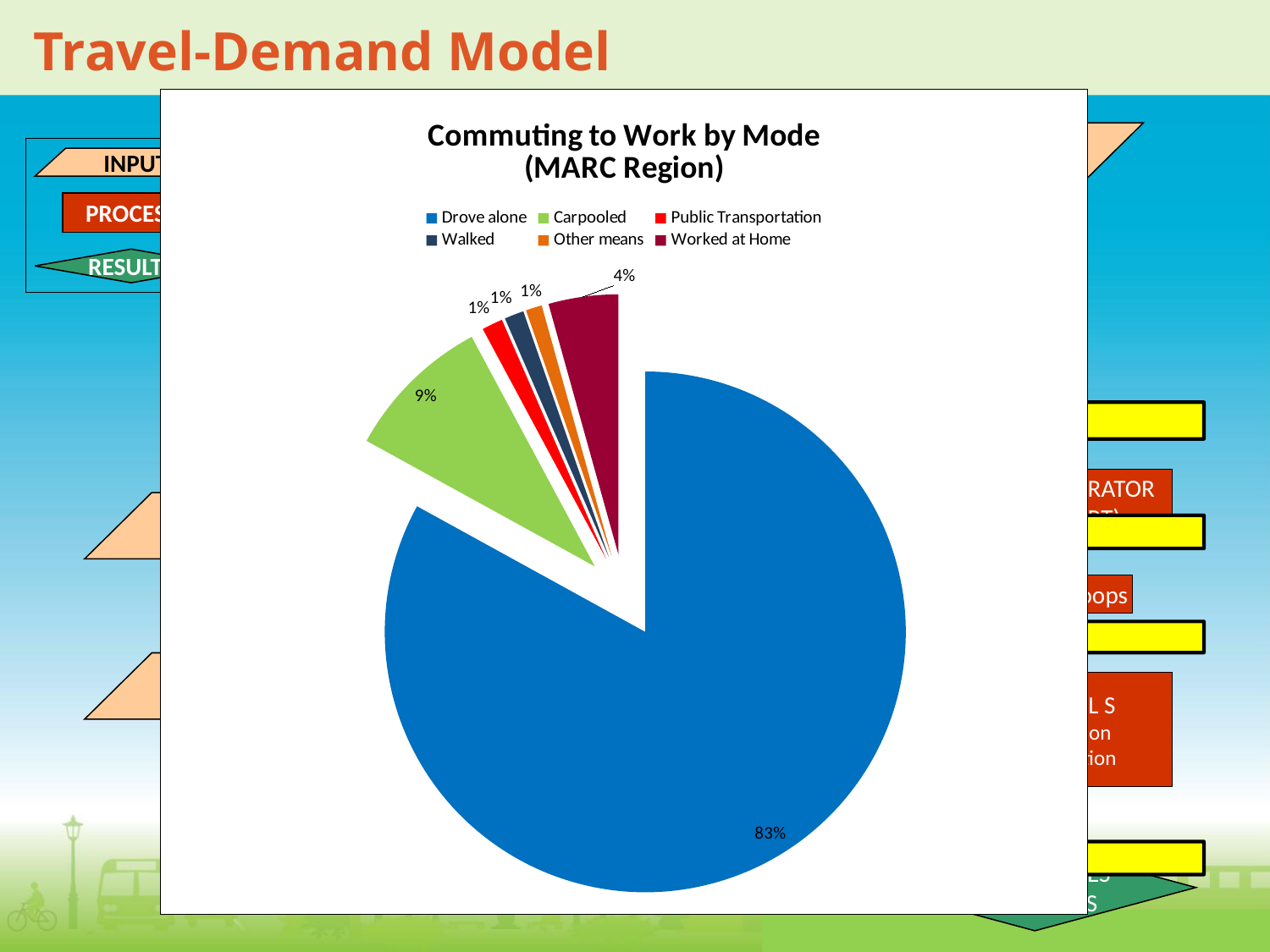
Which commuting mode has the largest share of the pie? Drove alone What is the title of the chart? Commuting to Work by Mode (MARC Region) What percentage of commuters used public transportation? 1% What colour is the Drove alone slice? Blue What percentage of commuters worked at home? 4% How many entries does the legend list? 6 What share of commuters in the MARC Region drove alone? 83% What percentage of commuters carpooled? 9% How many commuting modes are shown in the pie chart? 6 What type of chart is shown on the slide? Pie chart By how many percentage points does the Drove alone share exceed the Carpooled share? 74 percentage points Which is larger, the share for Carpooled or the share for Worked at Home? Carpooled